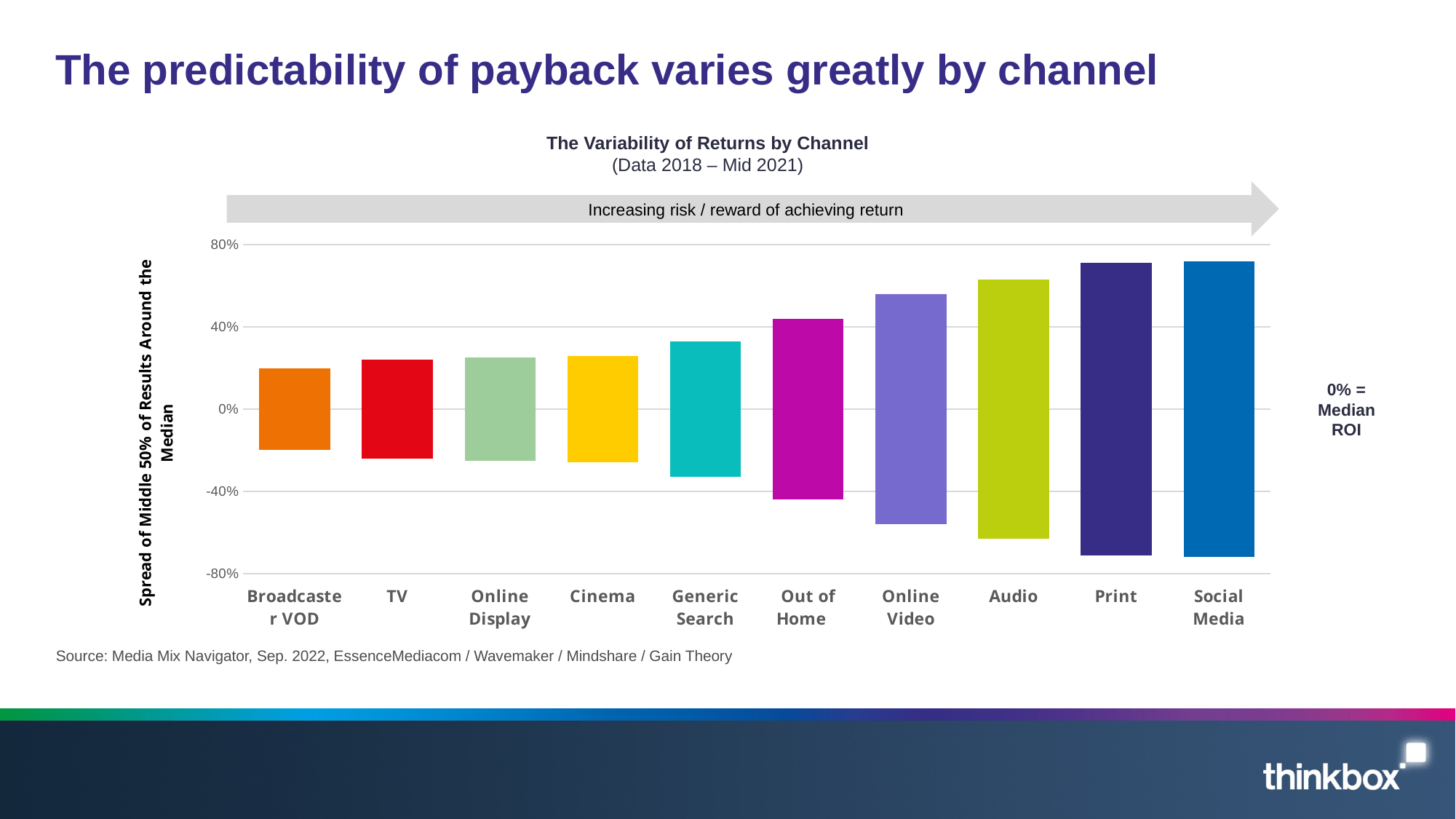
Which channel has the narrowest spread of results around the median? Broadcaster VOD How many channels are plotted on the x axis of the chart? 10 What does the label on the arrow above the chart say? Increasing risk / reward of achieving return Is the top of the bar for Generic Search greater or less than 40%? less What kind of chart is shown on the slide? bar chart Is the top of the bar for Online Video greater or less than 40%? greater Is the top of the bar for Print greater or less than 80%? less What is the title of the chart? The Variability of Returns by Channel (Data 2018 – Mid 2021) Which channel has a wider spread of results: Out of Home or Cinema? Out of Home Does the spread of results around the median increase or decrease moving from left to right across the channels? increase